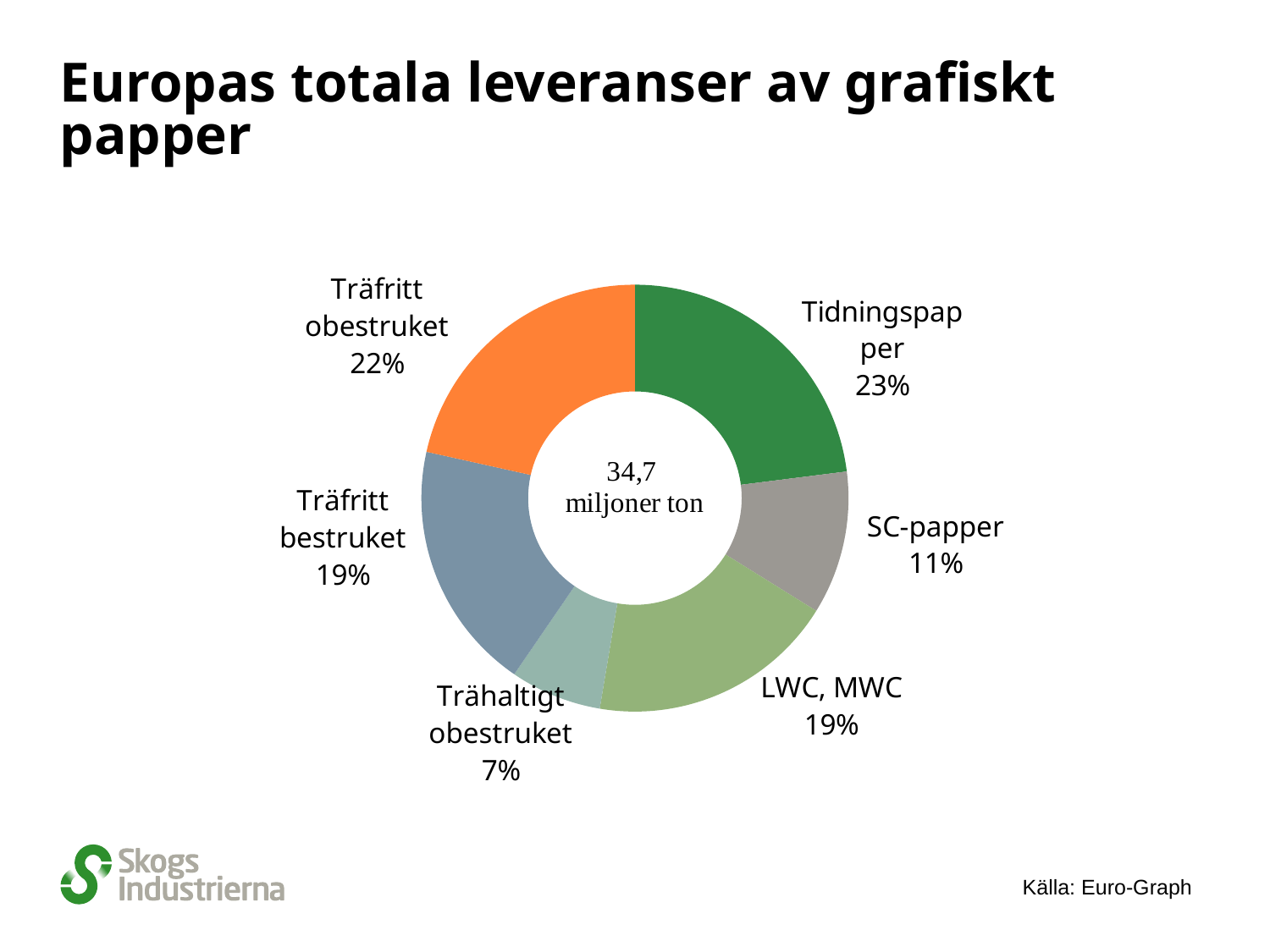
How many categories are shown in the chart? 6 What share of the chart does LWC, MWC account for? 19% What kind of chart is shown on the slide? Donut (pie) chart What share of the chart does Träfritt obestruket account for? 22% What share of the chart does Tidningspapper account for? 23% Which category has the largest share of the chart? Tidningspapper What total is shown in the centre of the donut chart? 34,7 miljoner ton What is the difference in percentage points between Träfritt obestruket and SC-papper? 11 percentage points Which category has the smallest share of the chart? Trähaltigt obestruket Which is larger, the share for Träfritt bestruket or the share for Trähaltigt obestruket? Träfritt bestruket